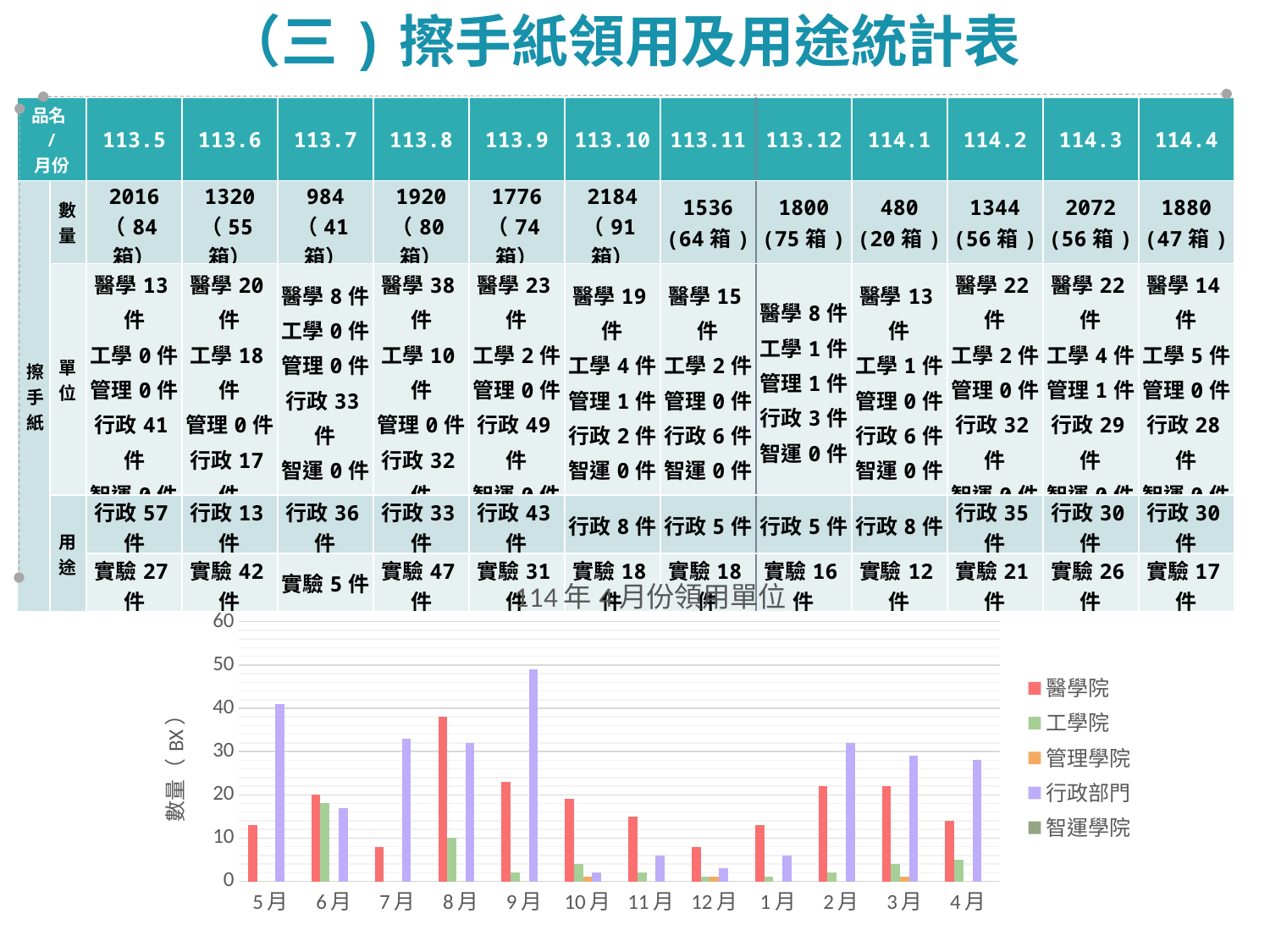
How many series does the legend of the bar chart list? 5 In the bar chart, which is larger in 12月, 醫學院 or 行政部門? 醫學院 In the bar chart, is the value for 行政部門 in 12月 greater or less than 10? less In the bar chart, is the value for 醫學院 in 8月 greater or less than 30? greater In the bar chart, which is larger in 5月, 醫學院 or 行政部門? 行政部門 In the bar chart, is the value for 行政部門 in 9月 greater or less than 40? greater In the bar chart, which is larger in 2月, 醫學院 or 行政部門? 行政部門 In the bar chart, which month has the tallest 醫學院 bar? 8月 What kind of chart is shown at the bottom of the slide? bar chart How many months are shown on the x axis of the bar chart? 12 What is the label on the y axis of the bar chart? 數量（BX） In the bar chart, which month has the tallest 行政部門 bar? 9月